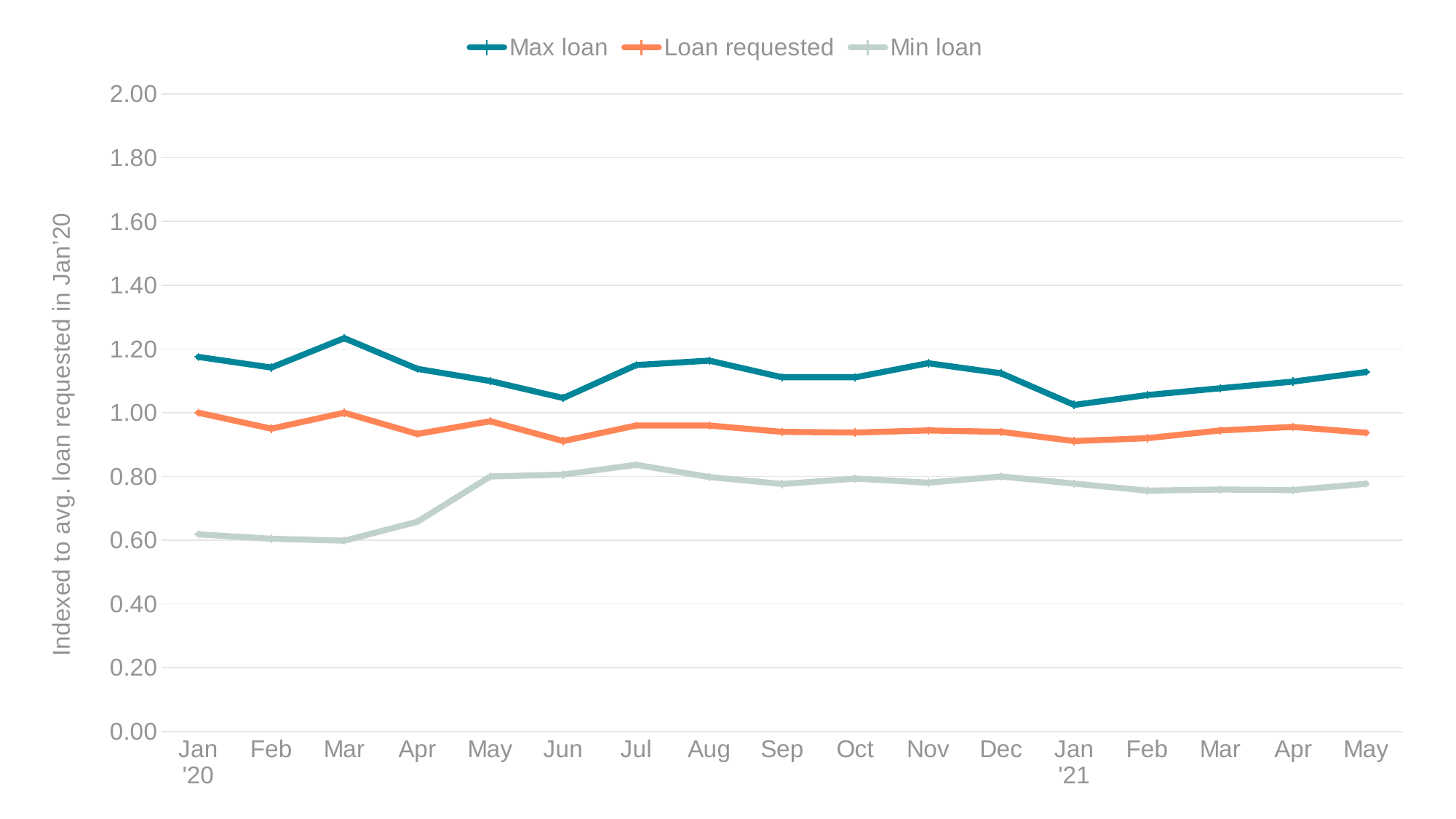
What kind of chart is shown on the slide? line chart In which month does the Min loan series reach its highest value? Jul '20 Is the value for Loan requested in Jun '20 greater or less than 1.00? less Which is larger in Jun '20, Max loan or Min loan? Max loan In which month does the Max loan series reach its highest value? Mar '20 Is the value for Min loan in Apr '20 greater or less than 0.80? less How many months are plotted along the x axis? 17 What is the title of the vertical axis? Indexed to avg. loan requested in Jan'20 What is the value of Loan requested in Jan '20? 1.00 How many series does the legend list? 3 Is the value for Max loan in Mar '20 greater or less than 1.20? greater Does the Min loan series rise or fall from Jan '20 to May '20? rise